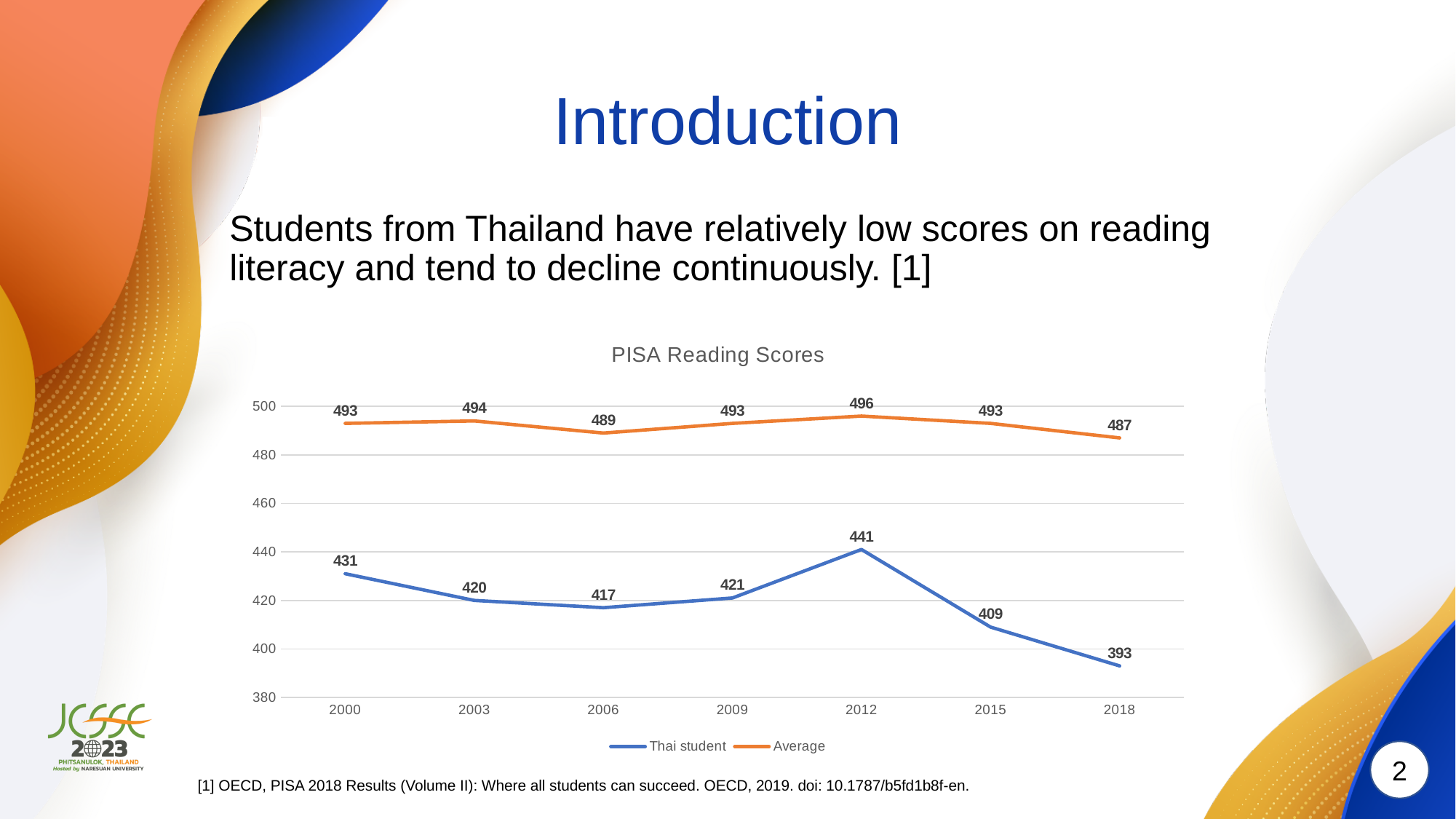
How many series does the legend list? 2 Does the Thai student score rise or fall from 2012 to 2018? fall What is the Average PISA reading score in 2012? 496 What is the Thai student PISA reading score in 2018? 393 Which colour is the Average series drawn in? orange What is the difference between the Average and Thai student scores in 2018? 94 Which is larger, the Thai student score in 2000 or in 2018? 2000 What is the title of the chart? PISA Reading Scores What kind of chart is shown? line chart How many years are plotted on the x axis? 7 In which year is the Average score lowest? 2018 In which year is the Thai student score highest? 2012